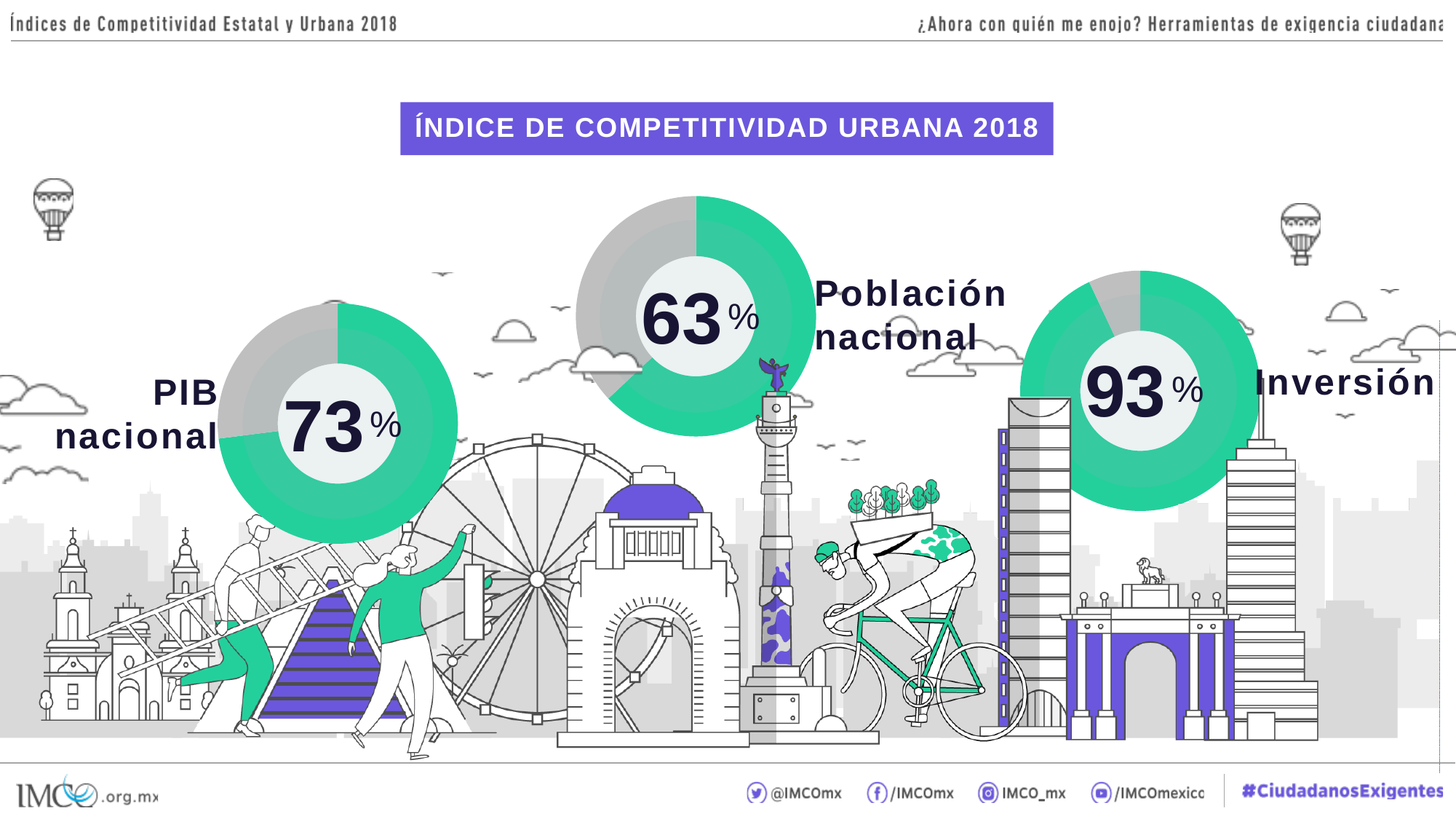
Which of the three donut charts shows the lowest percentage? Población nacional Which of the three donut charts shows the highest percentage? Inversión What is the title shown above the three donut charts? ÍNDICE DE COMPETITIVIDAD URBANA 2018 What percentage is shown in the PIB nacional donut chart? 73% What kind of chart is used to show the PIB nacional, Población nacional and Inversión values? Donut (pie) chart What is the difference between the PIB nacional percentage and the Población nacional percentage? 10% What percentage is shown in the Inversión donut chart? 93% How many donut charts are shown on the slide? 3 In the Inversión donut chart, what share of the ring is filled in green? 93% What percentage is shown in the Población nacional donut chart? 63% Which is larger, the percentage for PIB nacional or for Población nacional? PIB nacional What is the difference between the Inversión percentage and the PIB nacional percentage? 20%